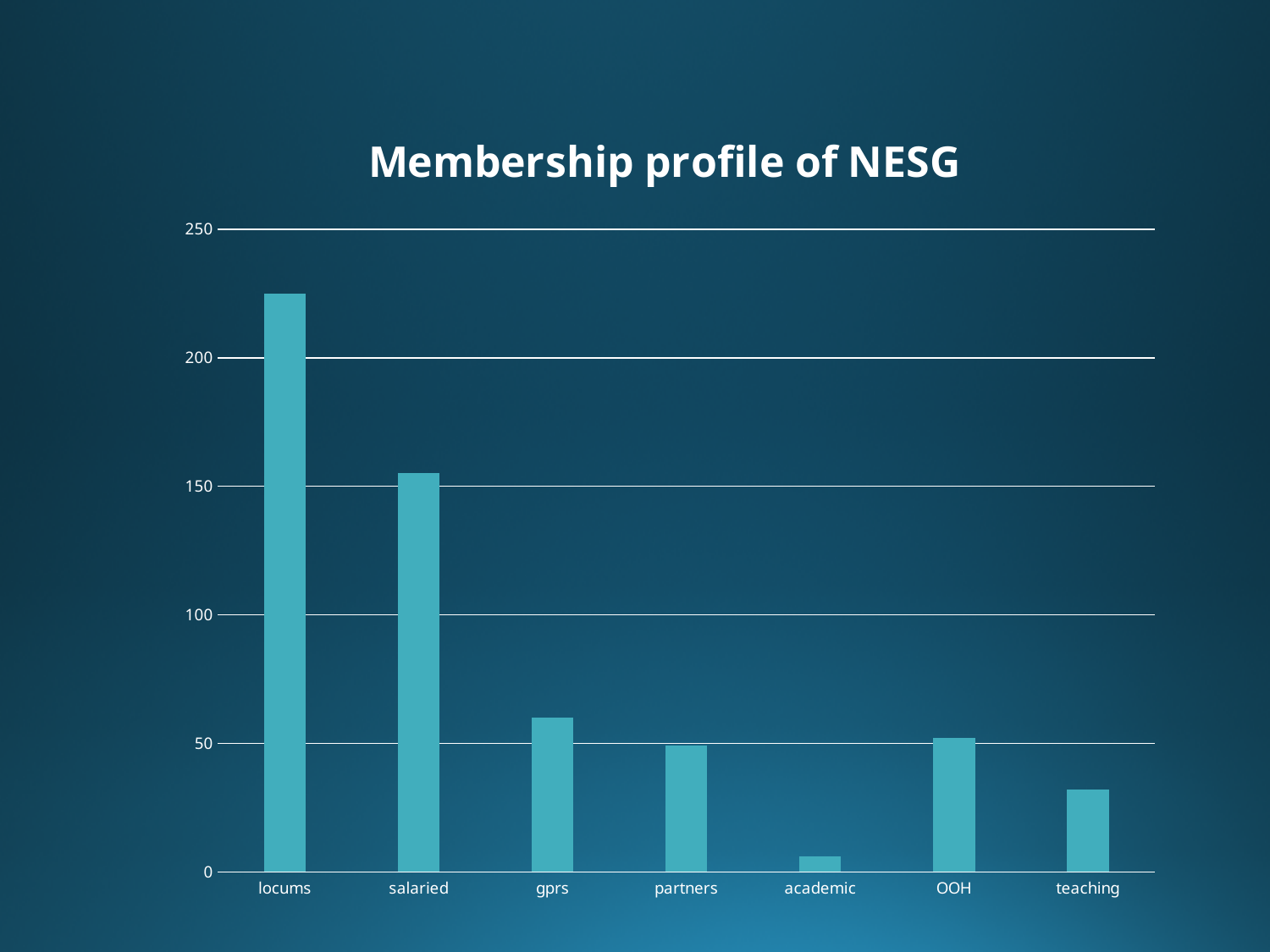
Which is larger, the value for locums or the value for salaried? locums Is the value for academic greater or less than 50? less Is the value for salaried greater or less than 100? greater What is the title of the chart? Membership profile of NESG Which category has the highest value? locums Is the value for teaching greater or less than 50? less What type of chart is shown on the slide? bar chart How many categories are shown on the x axis? 7 Which is larger, the value for gprs or the value for teaching? gprs Which category has the lowest value? academic